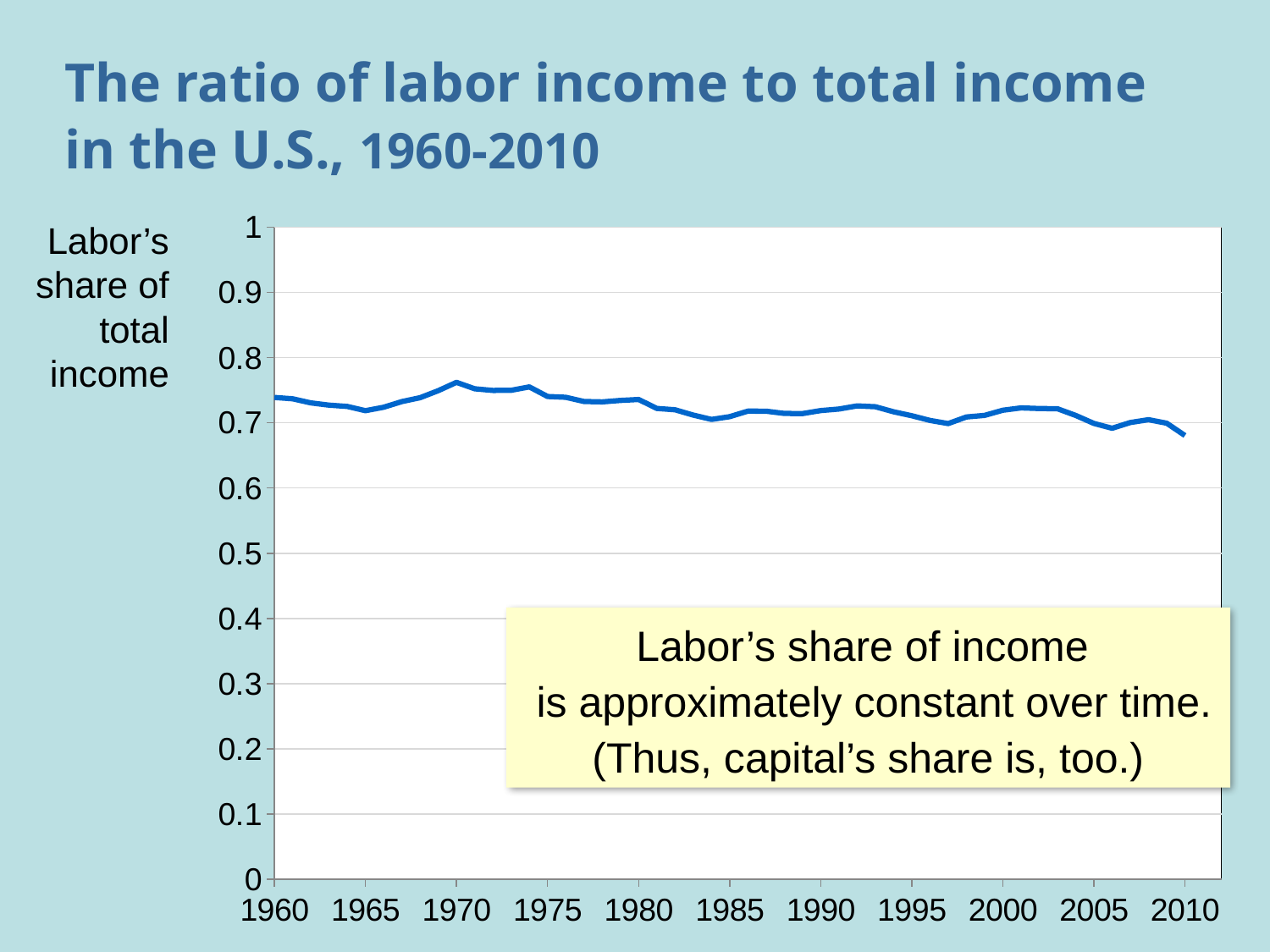
How many year labels are shown on the x axis? 11 Is the value for 1985 greater or less than 0.6? greater Is the value for 1970 greater or less than 0.7? greater What does the vertical axis of the chart measure? Labor's share of total income Is the value for 2010 greater or less than 0.8? less What kind of chart is shown on the slide? line chart Does the line rise or fall between 1965 and 1970? rises What is the title of the chart? The ratio of labor income to total income in the U.S., 1960-2010 Does the line rise or fall between 1970 and 1985? falls Around which year labelled on the x axis does the line reach its highest point? 1970